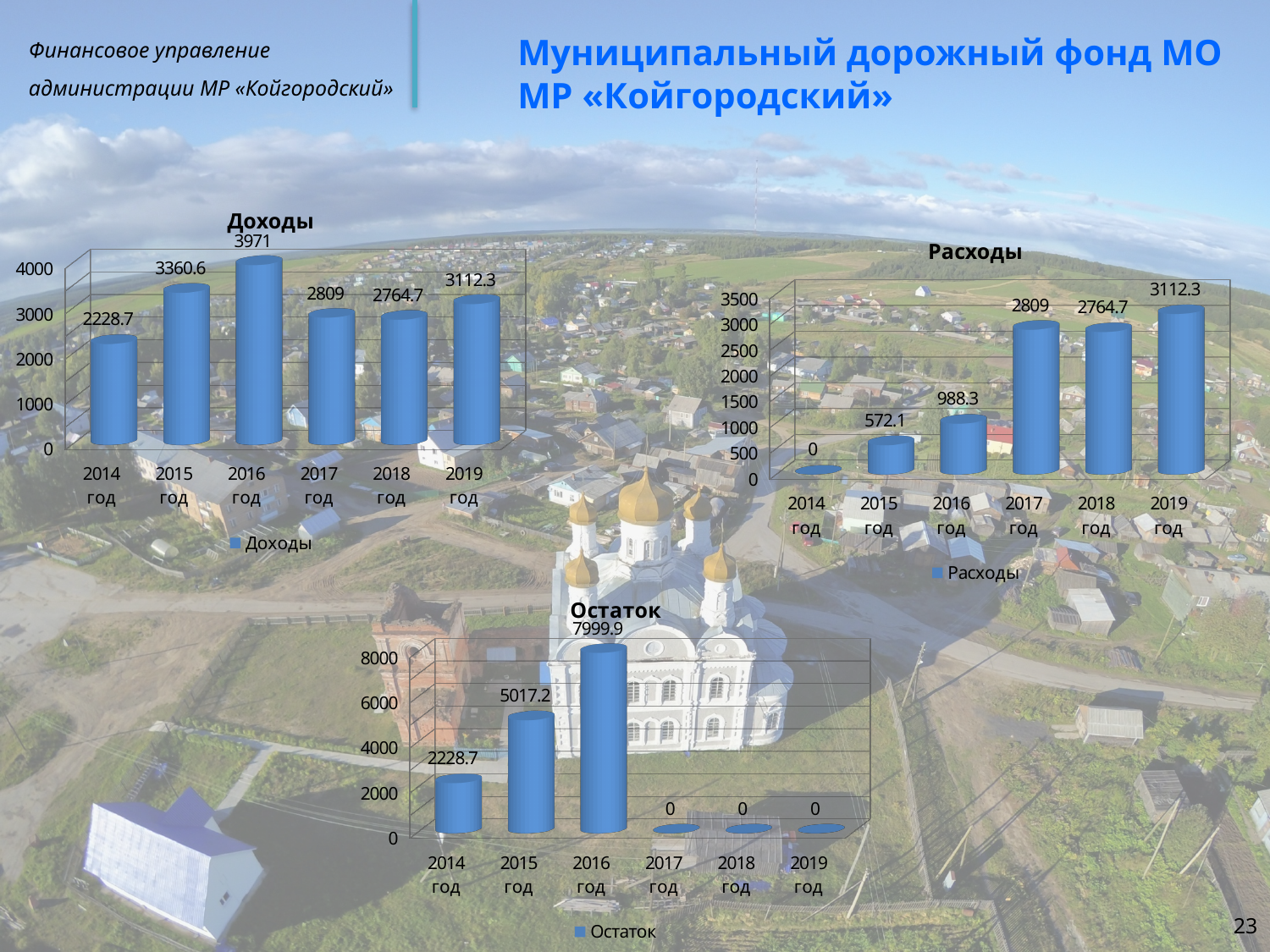
In the "Доходы" chart, what is the difference between the values for 2015 год and 2014 год? 1131.9 In the "Доходы" chart, what is the value for 2016 год? 3971 What type of chart is the "Расходы" chart? Bar chart In the "Остаток" chart, how many years have a value of 0? 3 In the "Остаток" chart, what is the value for 2016 год? 7999.9 How many categories are shown on the x axis of the "Доходы" chart? 6 In the "Доходы" chart, which year has the lowest value? 2014 год In the "Остаток" chart, what is the difference between the values for 2016 год and 2015 год? 2982.7 In the "Расходы" chart, which year has the highest value? 2019 год How many series does the legend of the "Остаток" chart list? 1 In the "Расходы" chart, which is larger: the value for 2017 год or 2018 год? 2017 год In the "Расходы" chart, what is the value for 2016 год? 988.3